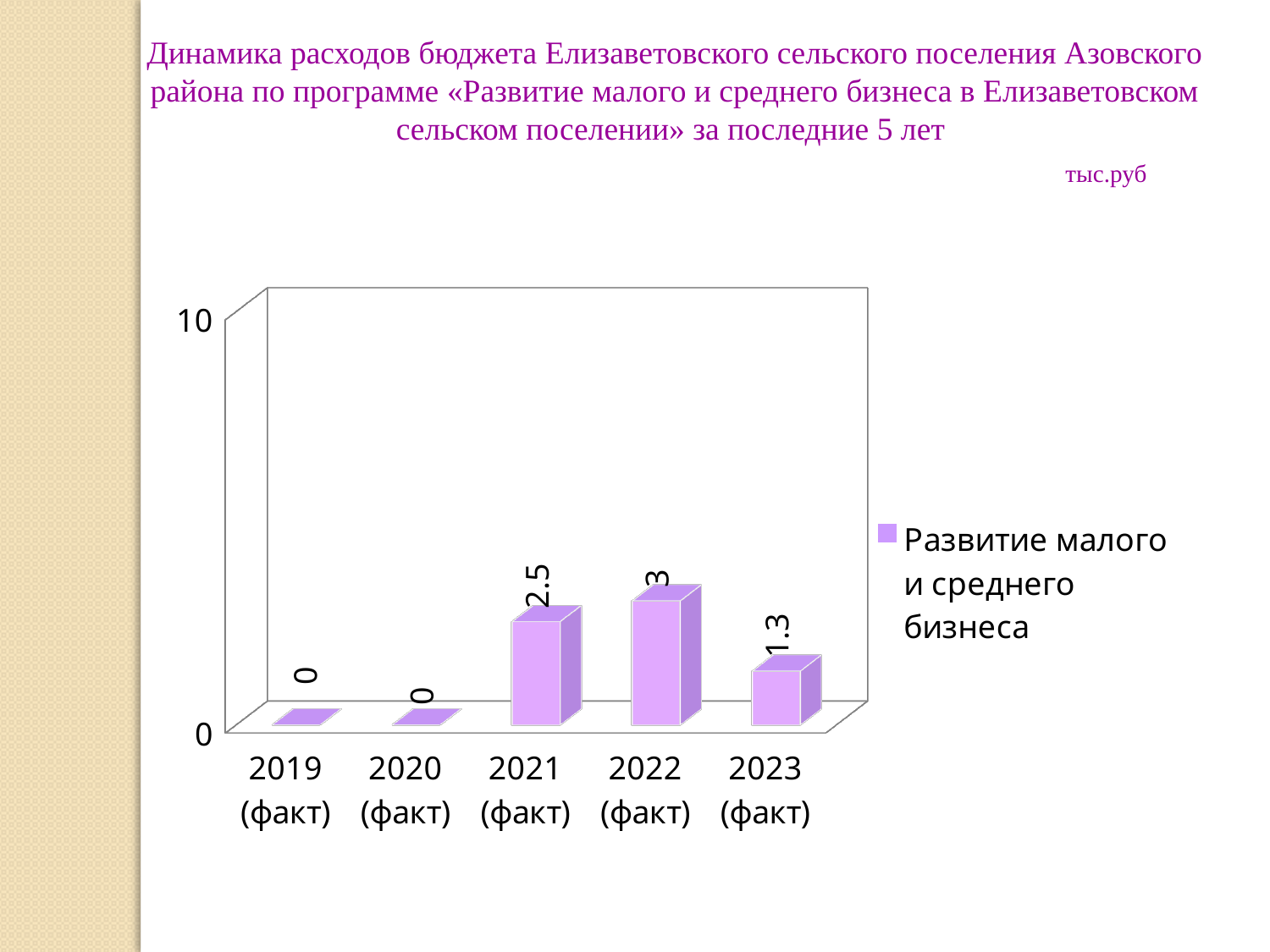
What is the value for 2023 (факт)? 1.3 What is the name of the series in the legend? Развитие малого и среднего бизнеса What kind of chart is shown on the slide? bar chart Which is larger, the value for 2021 (факт) or 2023 (факт)? 2021 (факт) Which year has the highest value? 2022 (факт) How many categories are shown on the x axis? 5 What is the difference between the values for 2022 (факт) and 2023 (факт)? 1.7 How many series does the legend list? 1 What is the value for 2022 (факт)? 3 What is the value for 2021 (факт)? 2.5 What is the value for 2019 (факт)? 0 What is the difference between the values for 2022 (факт) and 2021 (факт)? 0.5